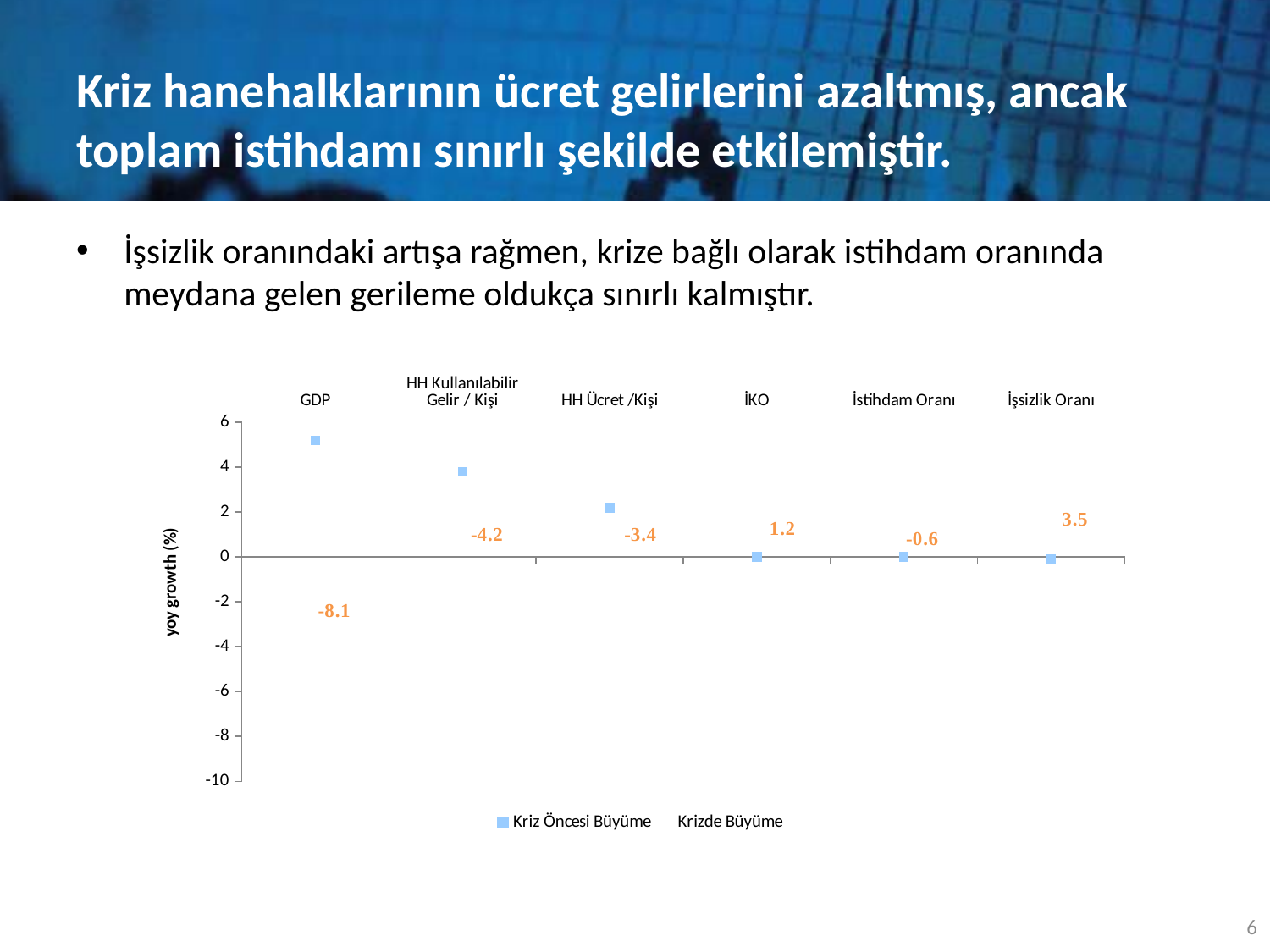
Which category has the lowest Krizde Büyüme value? GDP Which has the larger Krizde Büyüme value, İKO or İstihdam Oranı? İKO What is the Krizde Büyüme value for HH Ücret /Kişi? -3.4 What is the Krizde Büyüme value for GDP? -8.1 How many categories are shown on the x axis of the chart? 6 Which category has the highest Krizde Büyüme value? İşsizlik Oranı What is the Krizde Büyüme value for İşsizlik Oranı? 3.5 Is the Kriz Öncesi Büyüme value for GDP greater or less than 4? greater How many series does the chart legend list? 2 What is the Krizde Büyüme value for İKO? 1.2 Is the Kriz Öncesi Büyüme value for HH Ücret /Kişi greater or less than 4? less What is the difference between the Krizde Büyüme values for HH Kullanılabilir Gelir / Kişi and HH Ücret /Kişi? 0.8